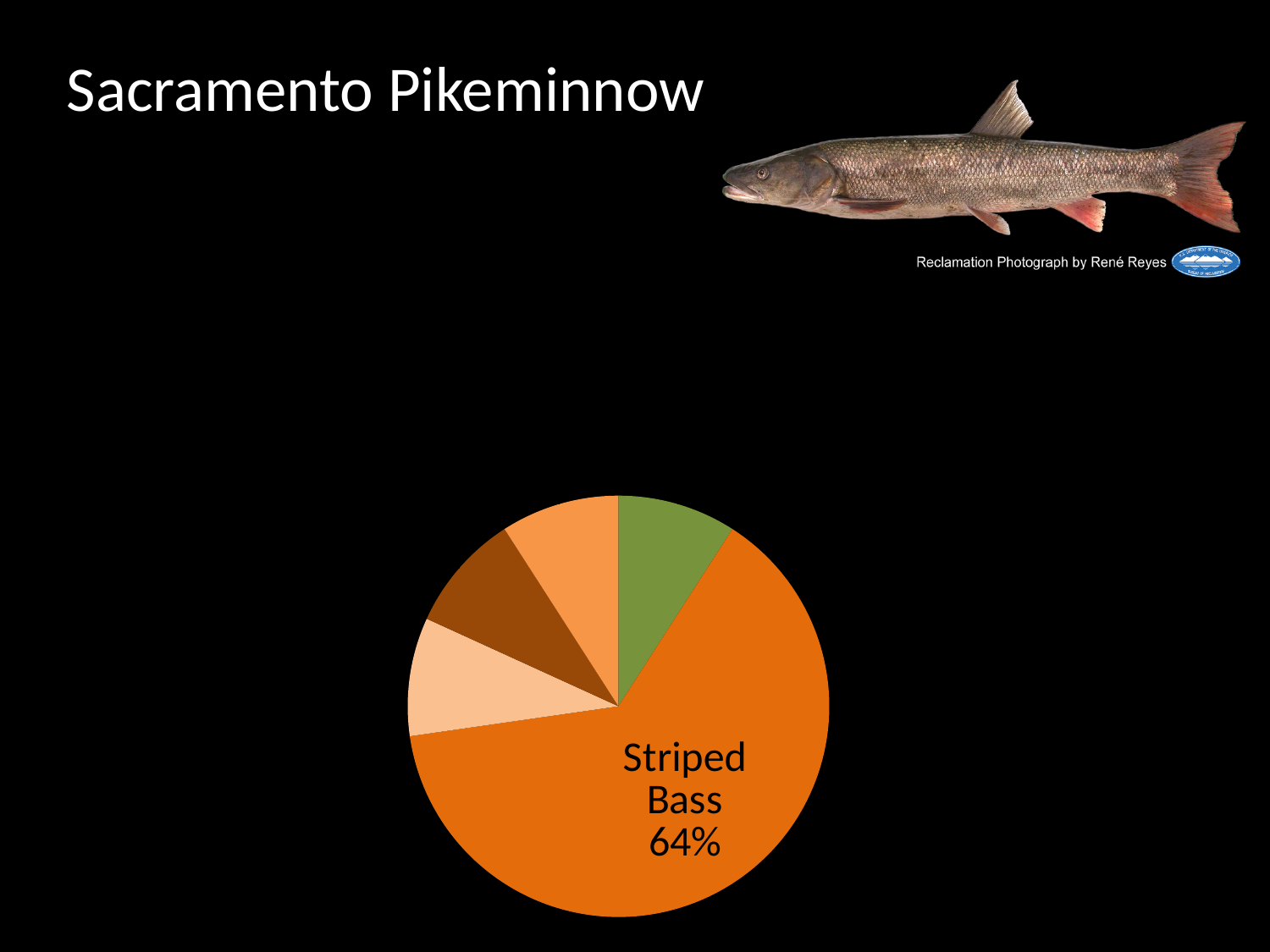
How many slices does the pie chart have? 5 Which slice of the pie chart has a printed label? Striped Bass Which slice of the pie chart is the largest? Striped Bass What colour is the Striped Bass slice of the pie chart? orange What value is printed on the Striped Bass slice of the pie chart? 64% What share of the pie chart does Striped Bass account for? 64% What kind of chart is shown on the slide? pie chart Does the Striped Bass slice make up more or less than half of the pie chart? more